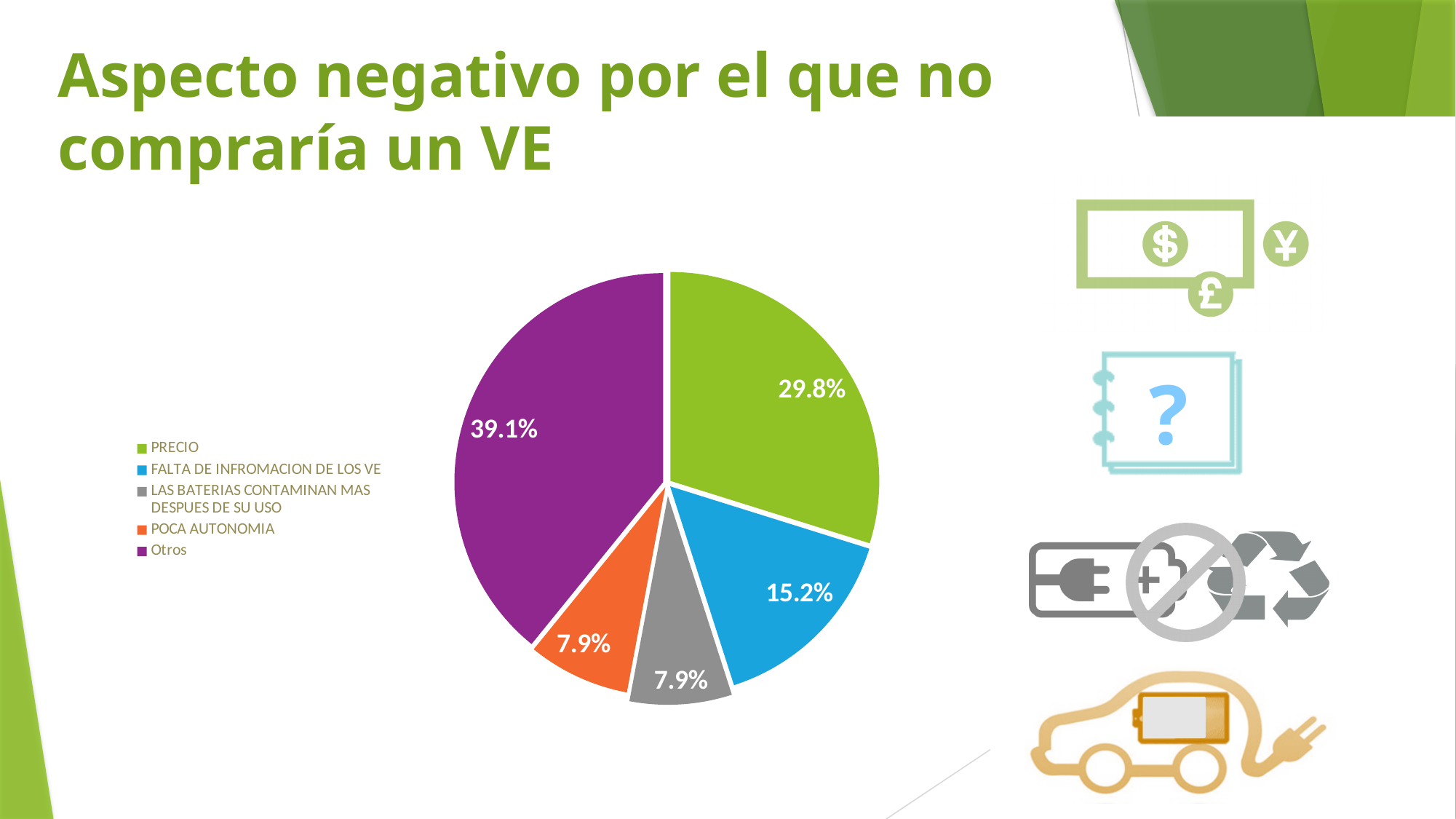
What percentage of the pie corresponds to POCA AUTONOMIA? 7.9% Which category has the largest slice of the pie? Otros What kind of chart is shown on the slide? pie chart What percentage of the pie corresponds to PRECIO? 29.8% Which is larger, the slice for PRECIO or the slice for FALTA DE INFROMACION DE LOS VE? PRECIO What is the difference in percentage points between the PRECIO slice and the FALTA DE INFROMACION DE LOS VE slice? 14.6 What percentage of the pie corresponds to FALTA DE INFROMACION DE LOS VE? 15.2% What percentage of the pie corresponds to Otros? 39.1% What percentage of the pie corresponds to LAS BATERIAS CONTAMINAN MAS DESPUES DE SU USO? 7.9% What colour is the slice for Otros? purple How many slices does the pie chart have? 5 What is the difference in percentage points between the Otros slice and the PRECIO slice? 9.3